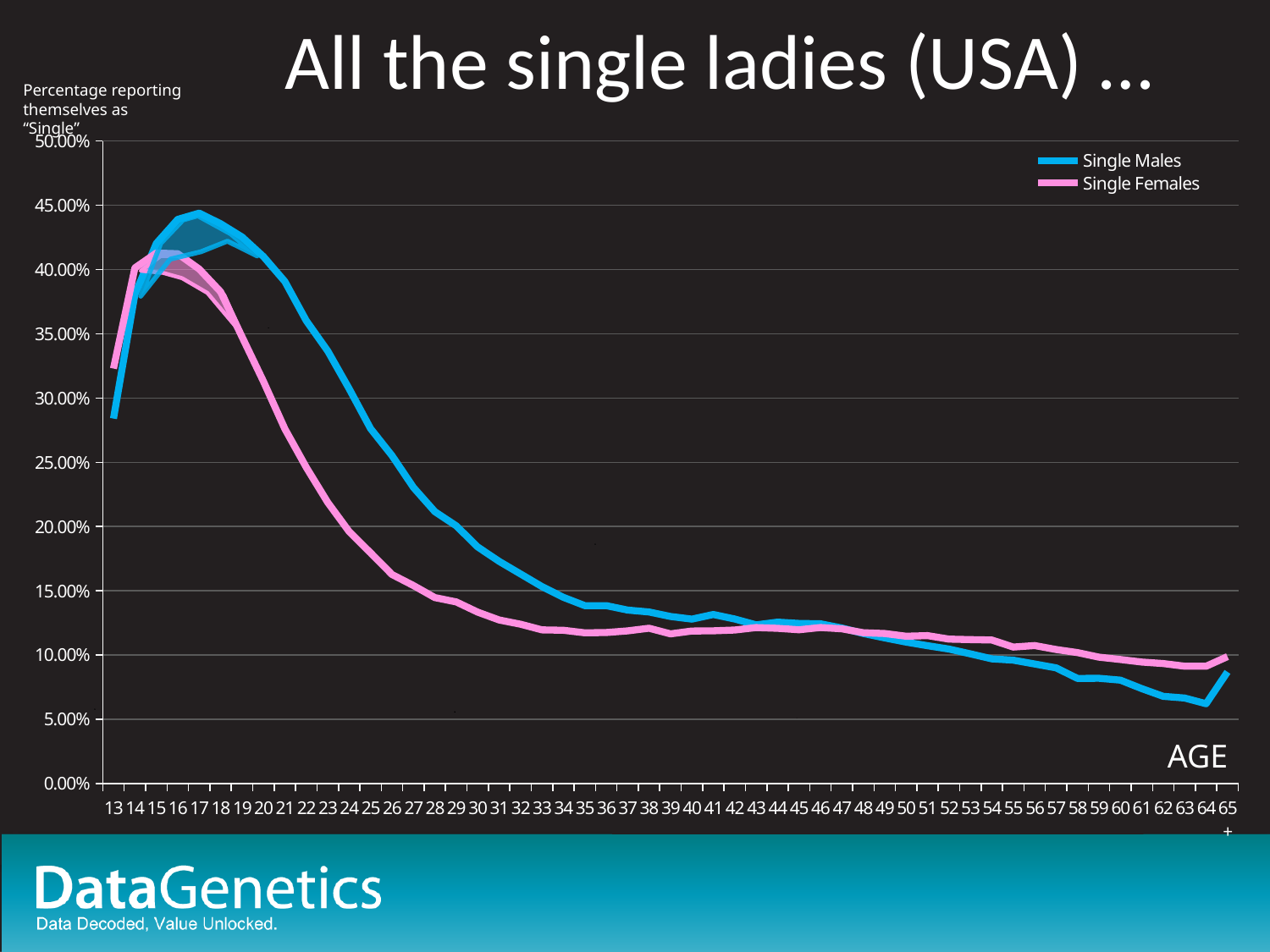
What are the two series named in the legend? Single Males and Single Females How many series does the legend list? 2 Is the value for Single Females at age 30 greater or less than 15.00%? less At which age does the Single Males series reach its highest value? 17 Is the value for Single Males at age 64 greater or less than 10.00%? less Between ages 20 and 35, do the values for Single Males rise or fall? fall Is the value for Single Males at age 17 greater or less than 40.00%? greater At age 20, which series has the higher value, Single Males or Single Females? Single Males What is the title of the chart? All the single ladies (USA) … At age 60, which series has the higher value, Single Males or Single Females? Single Females What kind of chart is shown on the slide? line chart